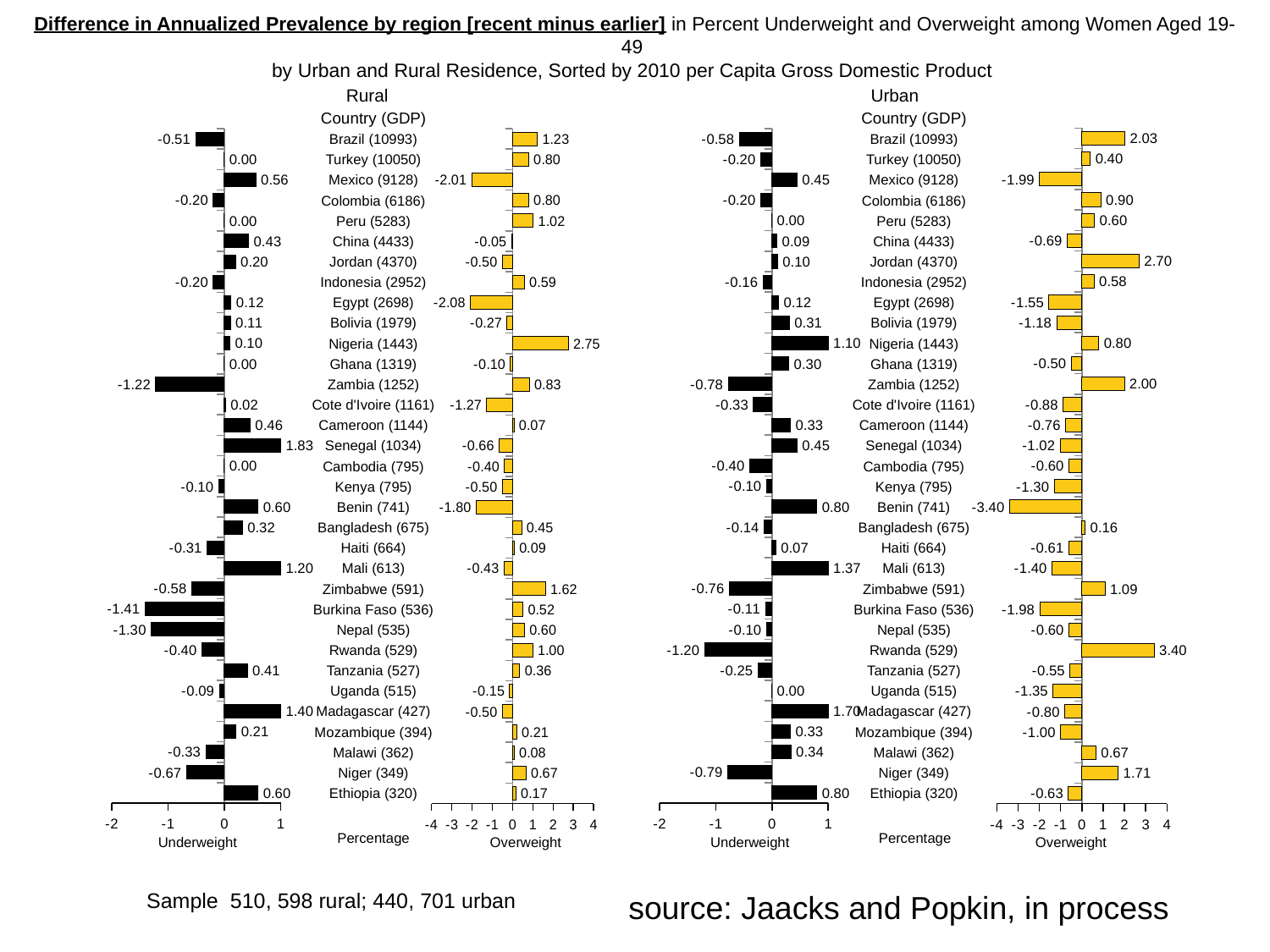
What kind of chart is the Urban Overweight chart? bar chart In the Urban Underweight chart, is the value for Rwanda (529) greater or less than -1? less In the Urban Overweight chart, what is the difference between the values for Brazil (10993) and Turkey (10050)? 1.63 In the Rural Overweight chart, which is larger, the value for Zimbabwe (591) or the value for Brazil (10993)? Zimbabwe (591) In the Rural Underweight chart, which country has the highest value? Senegal (1034) In the Rural Underweight chart, which country has the lowest value? Burkina Faso (536) In the Urban Underweight chart, what is the value for Madagascar (427)? 1.70 In the Urban Overweight chart, which country has the lowest value? Benin (741) In the Rural Overweight chart, what is the value for Egypt (2698)? -2.08 How many countries are listed in the Rural Underweight chart? 33 In the Urban Overweight chart, which country has the highest value? Rwanda (529) In the Rural Overweight chart, what is the value for Nigeria (1443)? 2.75